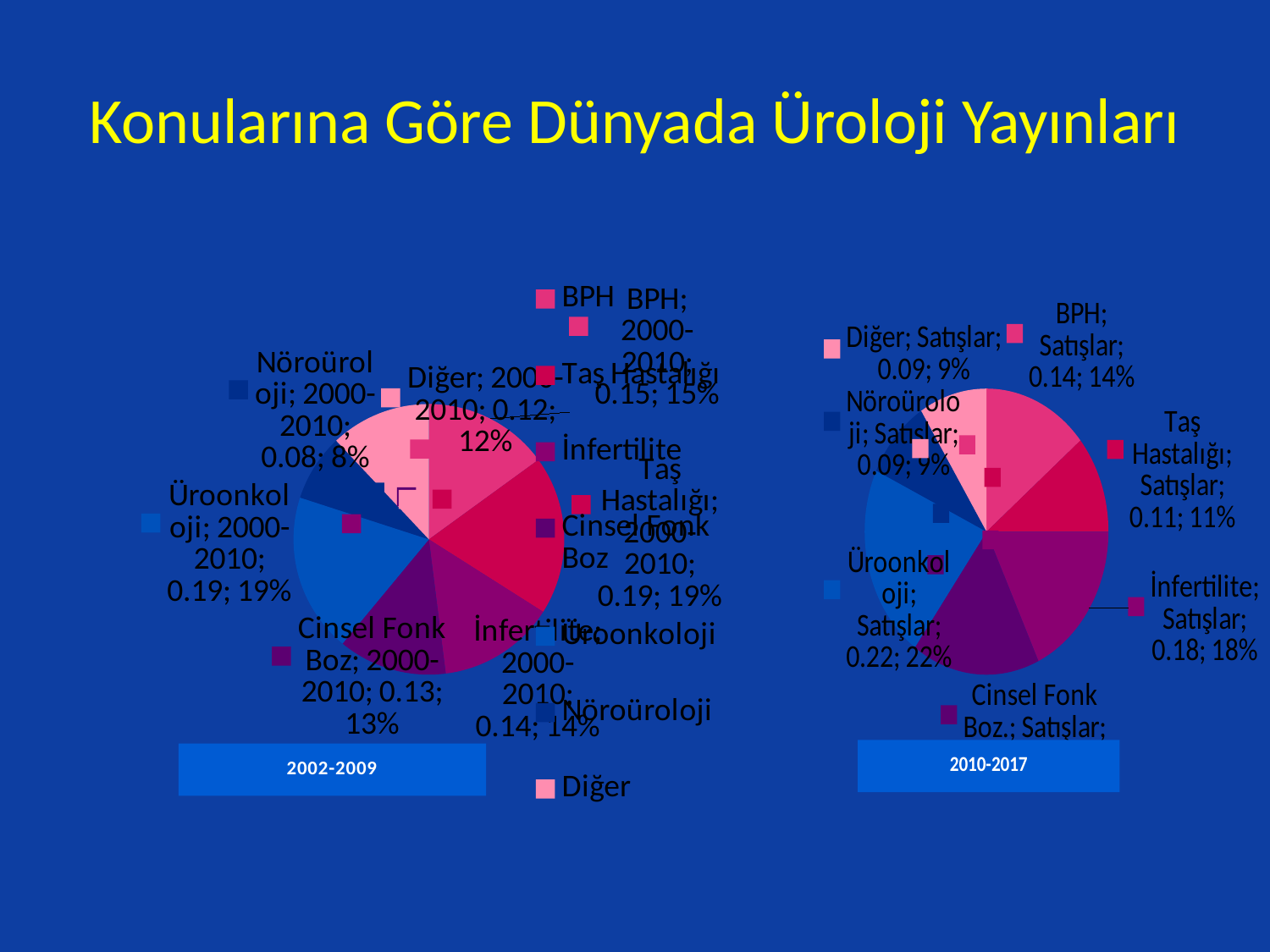
In the 2010-2017 pie chart, what share is Üroonkoloji? 22% In the 2002-2009 pie chart, which topic has the smallest share? Nöroüroloji In the 2002-2009 pie chart, which is larger: Üroonkoloji or Cinsel Fonk Boz? Üroonkoloji In the 2010-2017 pie chart, which topic has the largest share? Üroonkoloji What kind of chart is used on this slide for the 2002-2009 and 2010-2017 data? Pie chart In the 2002-2009 pie chart, what share is Nöroüroloji? 8% Is the share of Üroonkoloji larger in the 2002-2009 pie chart or in the 2010-2017 pie chart? 2010-2017 In the 2002-2009 pie chart, what share of publications is BPH? 15% How many slices does the 2002-2009 pie chart have? 7 How many entries does the legend of the 2002-2009 pie chart list? 7 In the 2010-2017 pie chart, what is the difference in percentage points between BPH (14%) and Taş Hastalığı (11%)? 3 percentage points